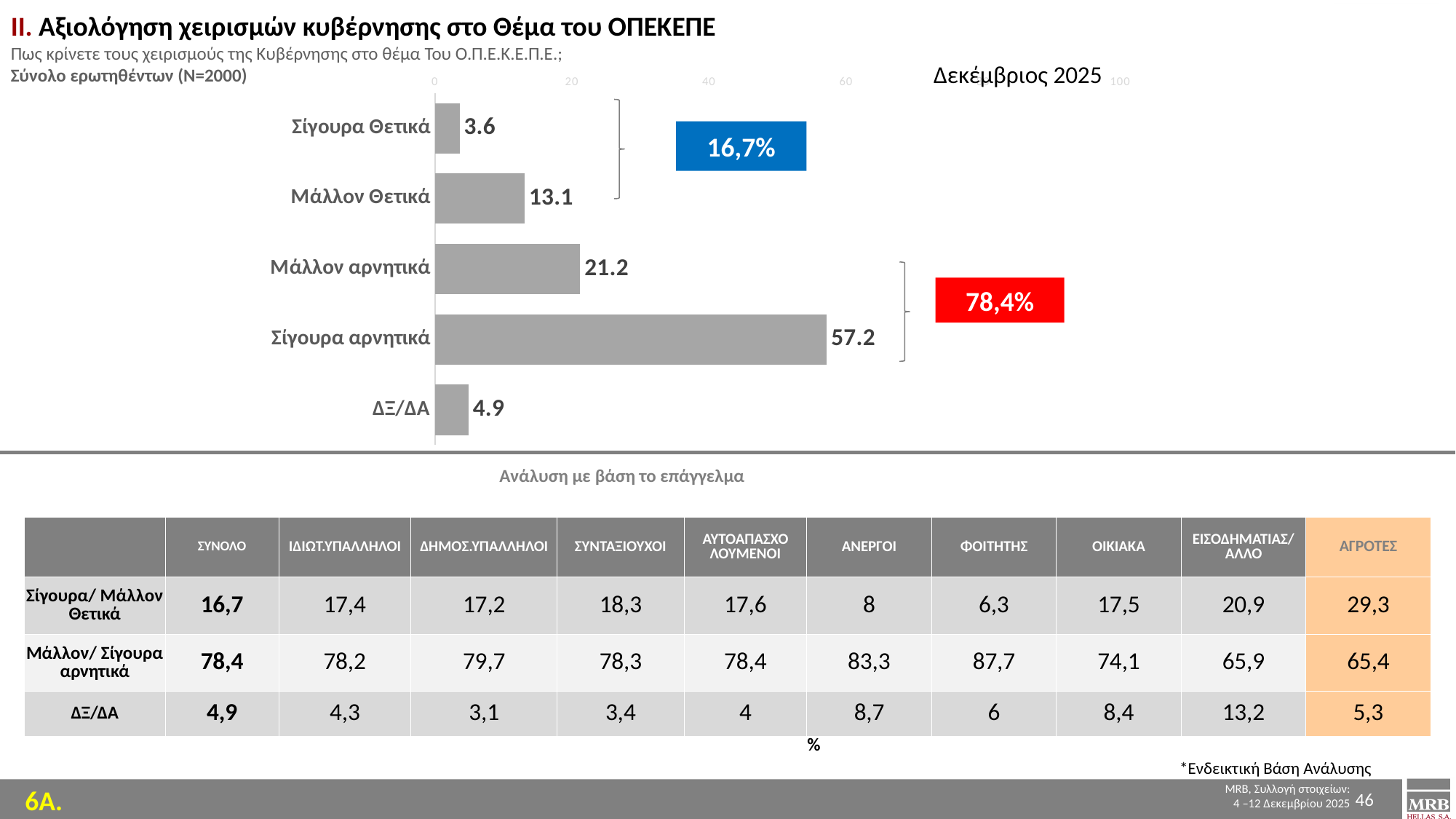
Is the value for Σίγουρα αρνητικά greater or less than 40? greater What is the value for Σίγουρα αρνητικά? 57.2 What percentage is shown in the red box next to the negative categories? 78,4% What is the difference between Σίγουρα αρνητικά and Μάλλον αρνητικά? 36.0 What percentage is shown in the blue box next to the positive categories? 16,7% What is the value for Μάλλον Θετικά? 13.1 What kind of chart is shown on the slide? bar chart Which category has the highest value? Σίγουρα αρνητικά What is the value for ΔΞ/ΔΑ in the bar chart? 4.9 Which is larger, Μάλλον Θετικά or Μάλλον αρνητικά? Μάλλον αρνητικά How many categories are shown in the bar chart? 5 Which category has the lowest value? Σίγουρα Θετικά